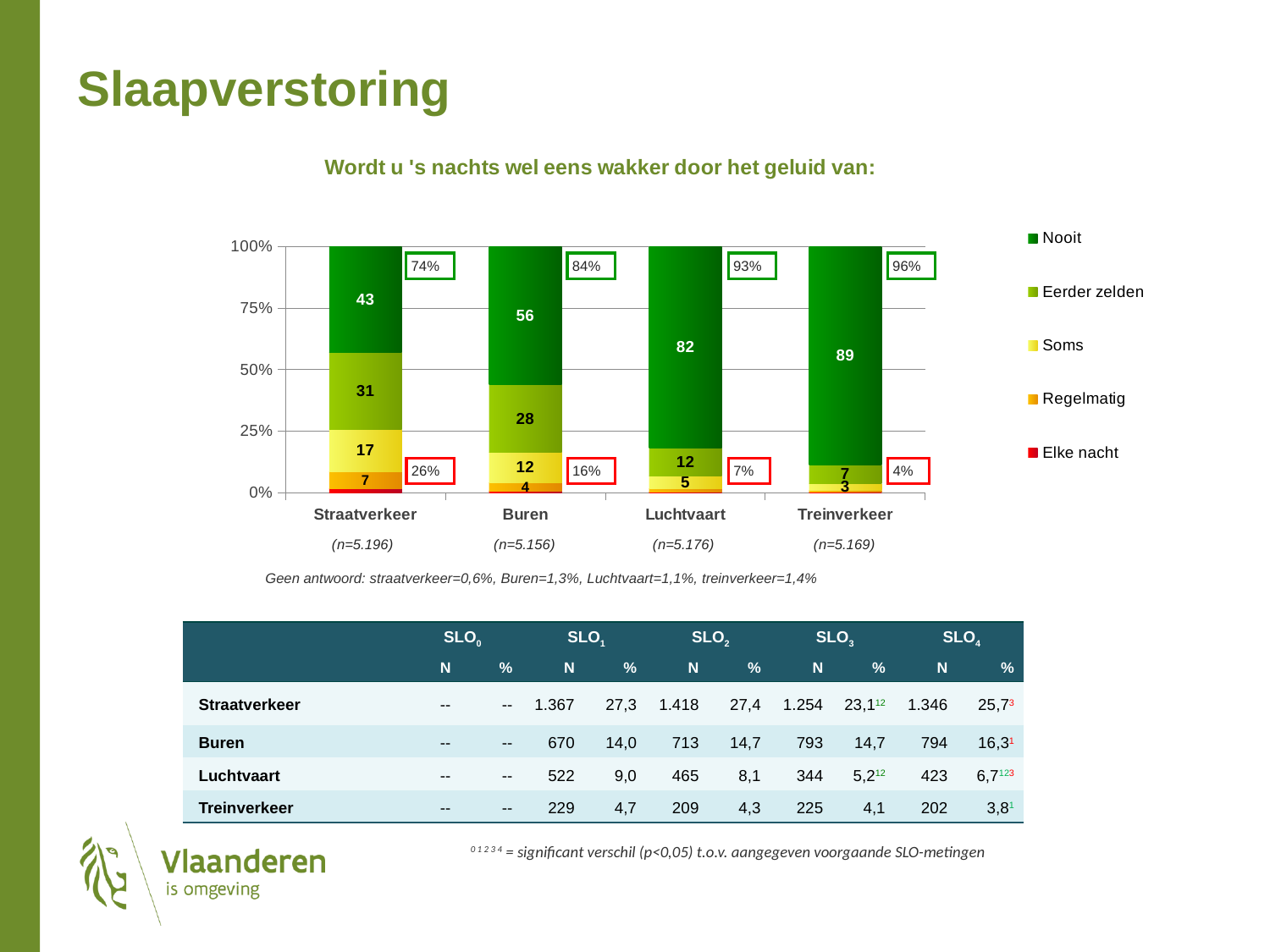
What is the value of the 'Eerder zelden' segment for Straatverkeer? 31 How many categories are shown on the x axis of the chart? 4 Which is larger: the 'Eerder zelden' value for Buren or for Luchtvaart? Buren What is the difference between the 'Nooit' values for Treinverkeer and Straatverkeer? 46 Which category has the highest 'Nooit' value? Treinverkeer What is the value of the 'Nooit' segment for Luchtvaart? 82 What percentage is shown in the upper box next to the Buren bar? 84% What kind of chart is shown on the slide? stacked bar chart What is the value of the 'Soms' segment for Buren? 12 Which category has the lowest 'Nooit' value? Straatverkeer Does the 'Nooit' value rise or fall from Straatverkeer to Treinverkeer along the x axis? rise How many series does the chart legend list? 5